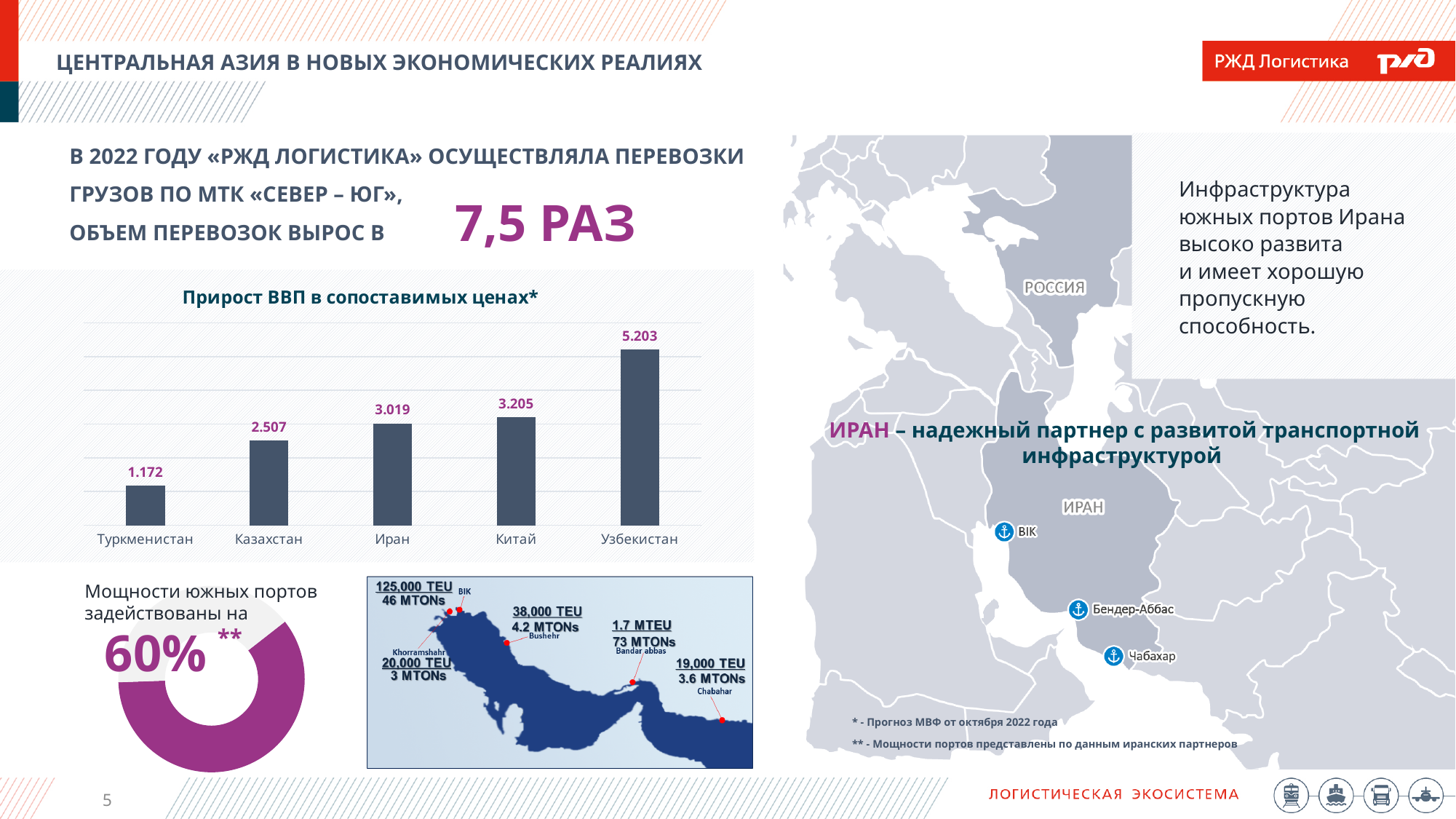
In the bar chart 'Прирост ВВП в сопоставимых ценах*', which is larger, the value for Казахстан or the value for Иран? Иран In the bar chart 'Прирост ВВП в сопоставимых ценах*', what is the value for Казахстан? 2.507 What kind of chart is 'Прирост ВВП в сопоставимых ценах*'? Bar chart In the bar chart 'Прирост ВВП в сопоставимых ценах*', which country has the highest value? Узбекистан In the bar chart 'Прирост ВВП в сопоставимых ценах*', what is the value for Китай? 3.205 Do the values in the bar chart 'Прирост ВВП в сопоставимых ценах*' rise or fall from left to right? Rise In the donut chart at the bottom left of the slide ('Мощности южных портов задействованы на'), what share is highlighted? 60% In the bar chart 'Прирост ВВП в сопоставимых ценах*', what is the difference between the values for Узбекистан and Туркменистан? 4.031 In the bar chart 'Прирост ВВП в сопоставимых ценах*', what is the value for Иран? 3.019 In the bar chart 'Прирост ВВП в сопоставимых ценах*', which country has the lowest value? Туркменистан How many countries are shown in the bar chart 'Прирост ВВП в сопоставимых ценах*'? 5 In the bar chart 'Прирост ВВП в сопоставимых ценах*', what is the difference between the values for Китай and Иран? 0.186